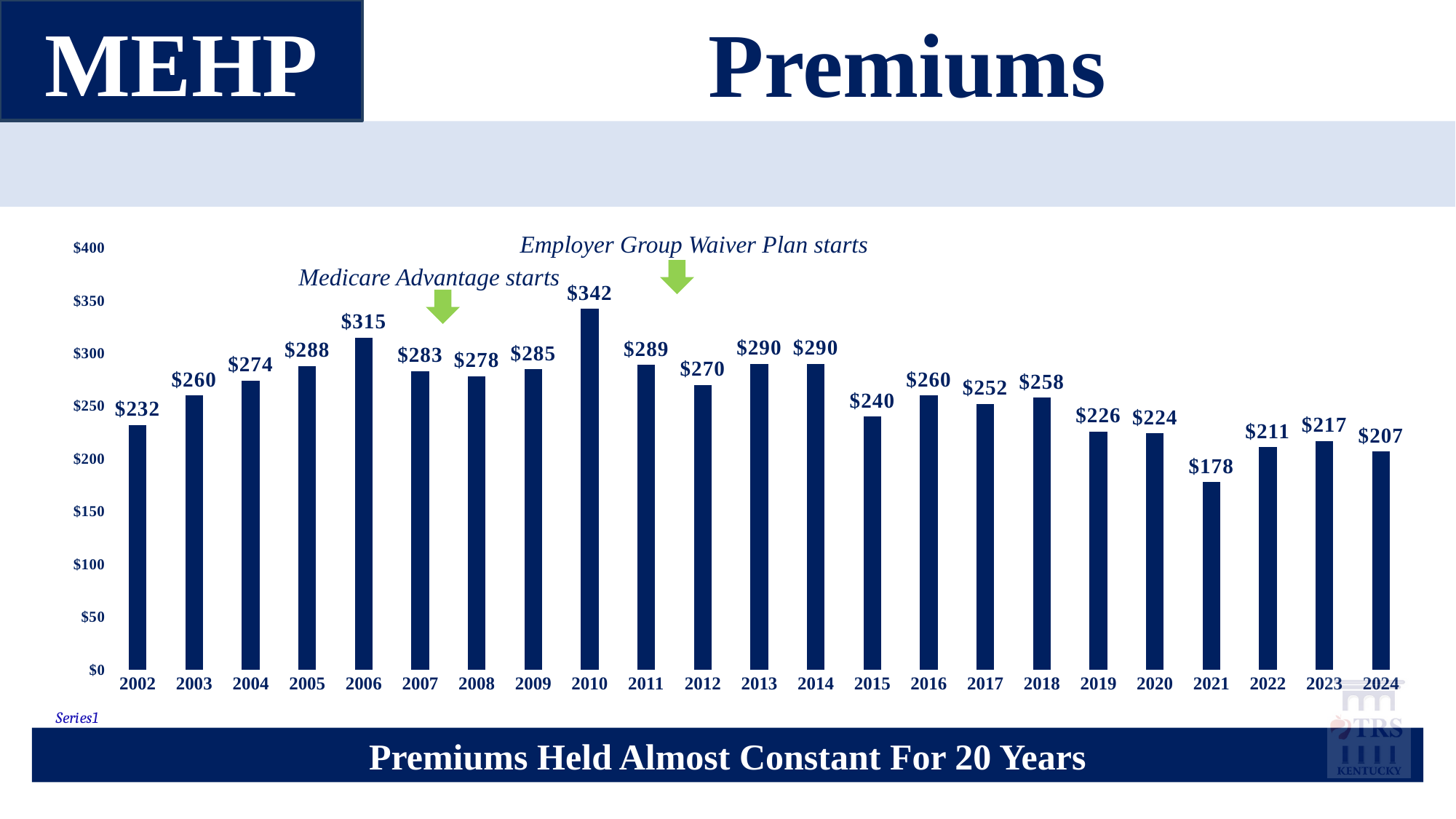
How many years are shown on the x axis? 23 What kind of chart is shown on the slide? bar chart What is the difference between the premium in 2010 and the premium in 2024? $135 Is the value for 2015 greater or less than $250? less What is the premium value shown for 2021? $178 What is the premium value shown for 2002? $232 Which is larger, the premium for 2006 or the premium for 2016? 2006 What is the premium value shown for 2010? $342 Which year has the highest premium? 2010 Do the premiums generally rise or fall from 2014 to 2021? fall What event does the annotation above the 2007 bar say starts? Medicare Advantage starts Which year has the lowest premium? 2021